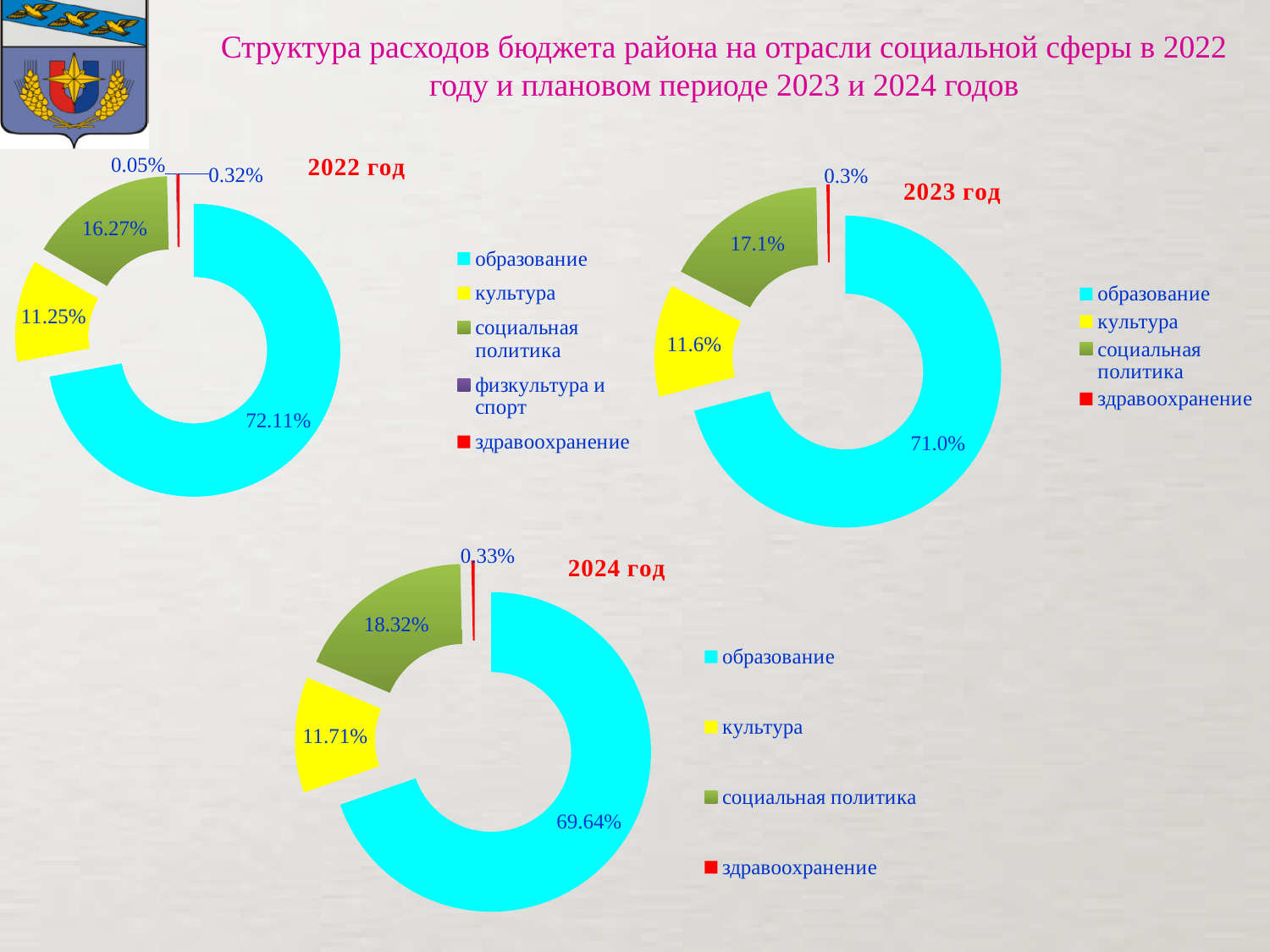
On the 2023 год chart, what share is shown for культура? 11.6% On the 2024 год chart, what is the difference between the shares of социальная политика and культура? 6.61% On the 2022 год chart, which is larger: the share of культура or the share of социальная политика? социальная политика What kind of chart is the 2023 год chart? doughnut (pie) chart On the 2024 год chart, which category has the largest share? образование How many entries does the legend of the 2024 год chart list? 4 On the 2022 год chart, what share is shown for образование? 72.11% On the 2024 год chart, what share is shown for здравоохранение? 0.33% On the 2022 год chart, what share is shown for социальная политика? 16.27% How many charts are shown on the slide? 3 On the 2023 год chart, which category has the smallest share? здравоохранение How many entries does the legend of the 2022 год chart list? 5